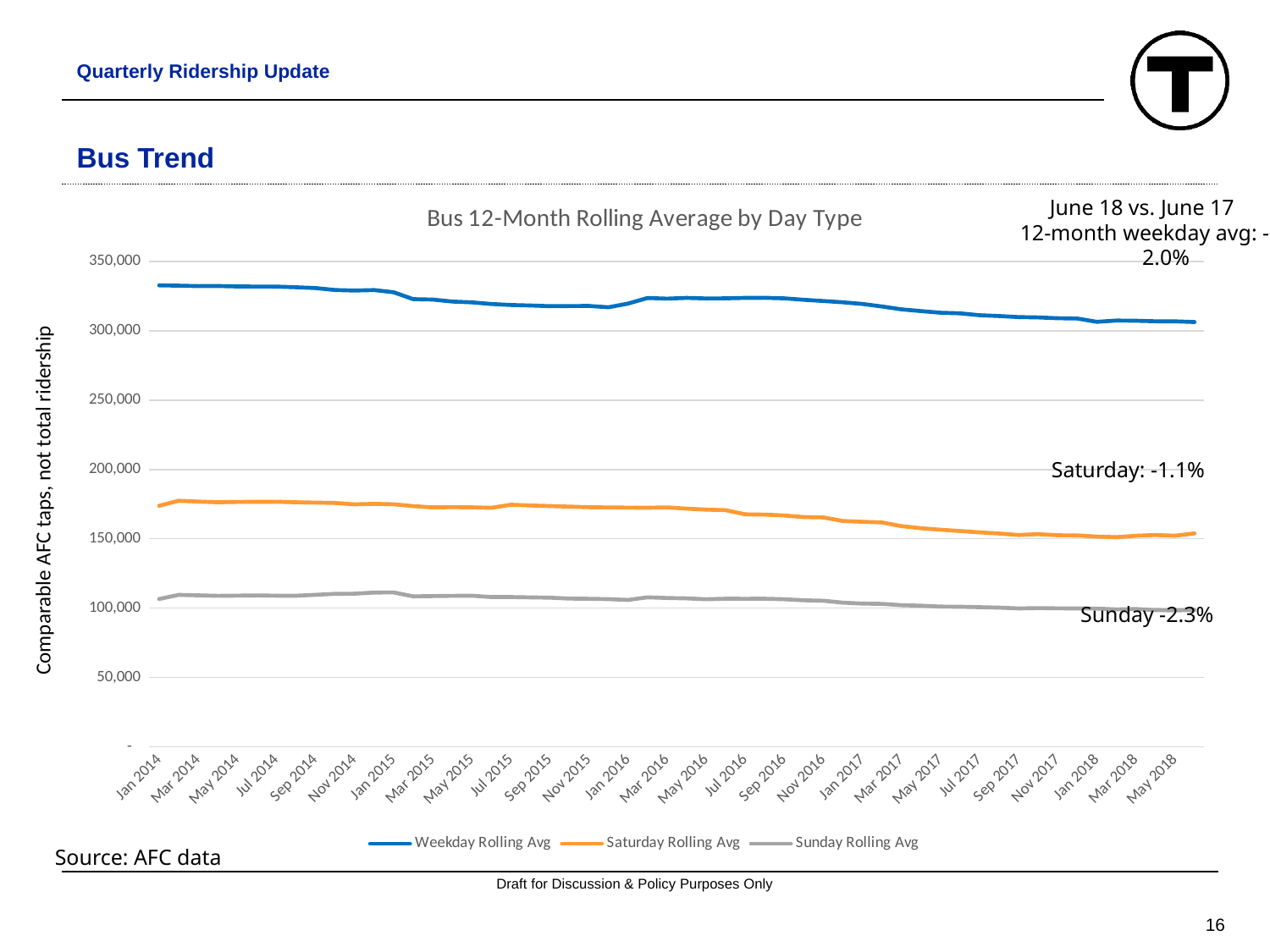
Is the Weekday Rolling Avg value for Jan 2014 greater or less than 350,000? less Is the Saturday Rolling Avg value for Jan 2014 greater or less than 150,000? greater Is the Weekday Rolling Avg value for Jan 2014 greater or less than 300,000? greater Which is larger in May 2018, the Weekday Rolling Avg or the Saturday Rolling Avg? Weekday Rolling Avg Does the Weekday Rolling Avg generally rise or fall from Jan 2014 to May 2018? fall How many series does the legend list? 3 What is the label on the vertical axis? Comparable AFC taps, not total ridership Which series has the lowest values throughout the chart? Sunday Rolling Avg What kind of chart is shown on the slide? line chart Which series has the highest values throughout the chart? Weekday Rolling Avg What is the title of the chart? Bus 12-Month Rolling Average by Day Type